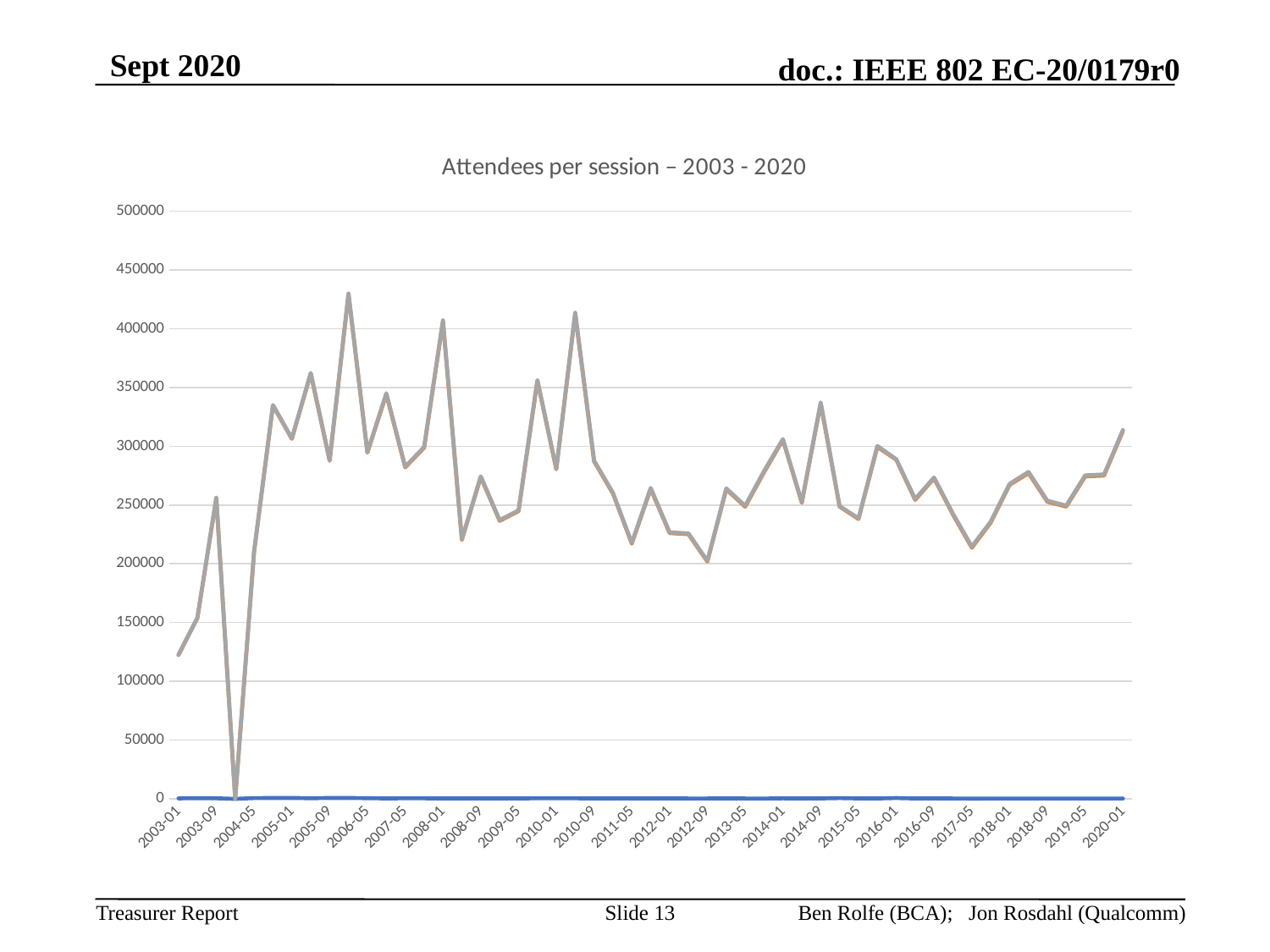
Which has the larger value, 2003-01 or 2014-09? 2014-09 What kind of chart is shown on the slide? line chart Is the value for 2010-09 greater or less than 400000? less Is the value for 2006-05 greater or less than 400000? less Is the value for 2014-09 greater or less than 300000? greater What is the title of the chart? Attendees per session – 2003 - 2020 Which has the larger value, 2006-05 or 2012-09? 2006-05 What is the highest value shown on the vertical axis? 500000